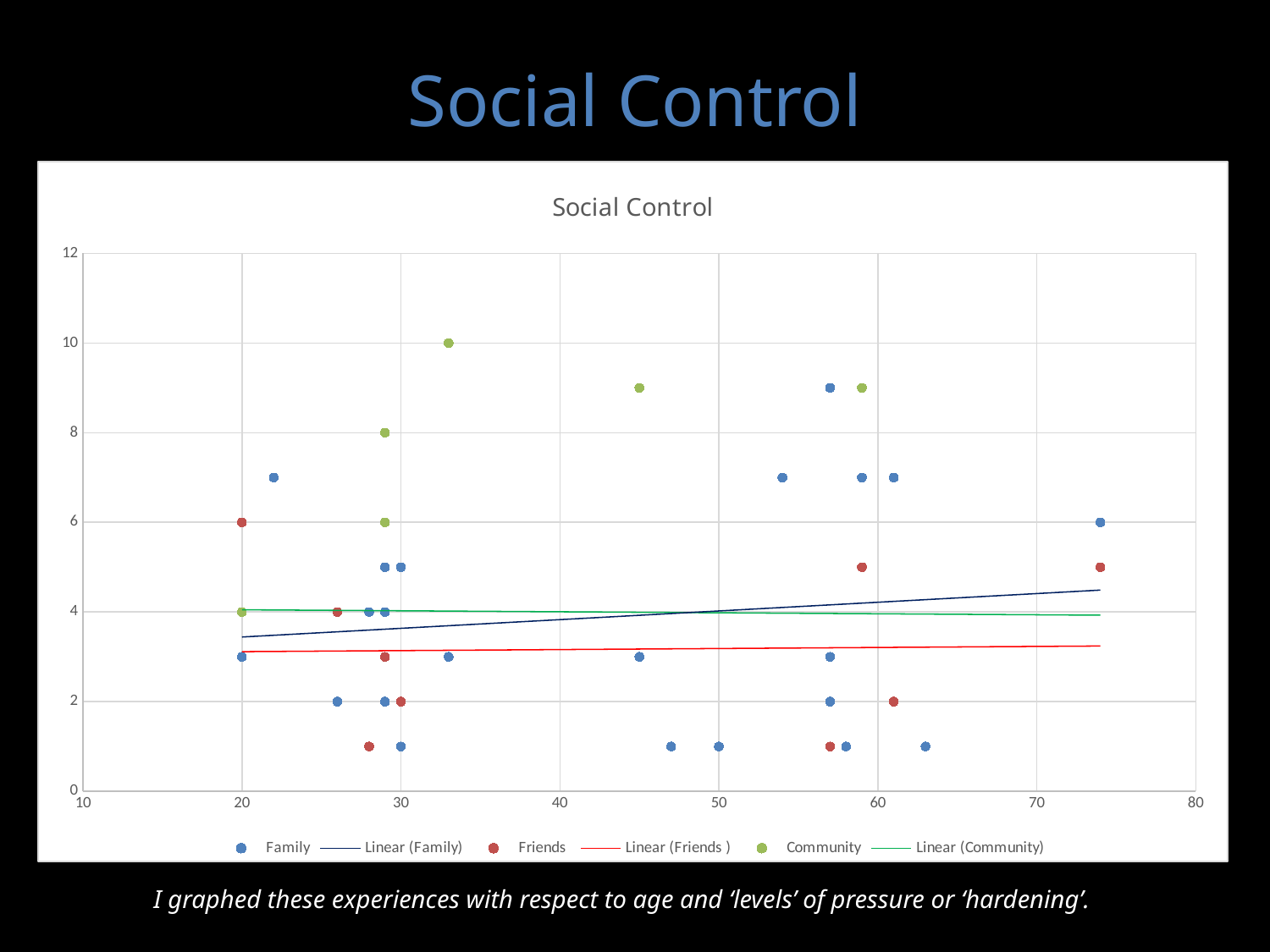
Which series has the highest plotted point on the chart? Community How many entries does the chart legend list? 6 What is the title of the chart? Social Control Does the Linear (Family) trendline rise or fall as age increases along the x axis? rises What kind of chart is shown on the slide? scatter chart What is the highest y value reached by any plotted point? 10 At age 74, which trendline is higher: Linear (Family) or Linear (Friends)? Linear (Family) What is the lowest y value reached by any plotted point? 1 Is the Linear (Family) trendline at age 74 greater or less than 4? greater Is the Linear (Family) trendline at age 20 greater or less than 4? less What is the highest value shown on the y axis? 12